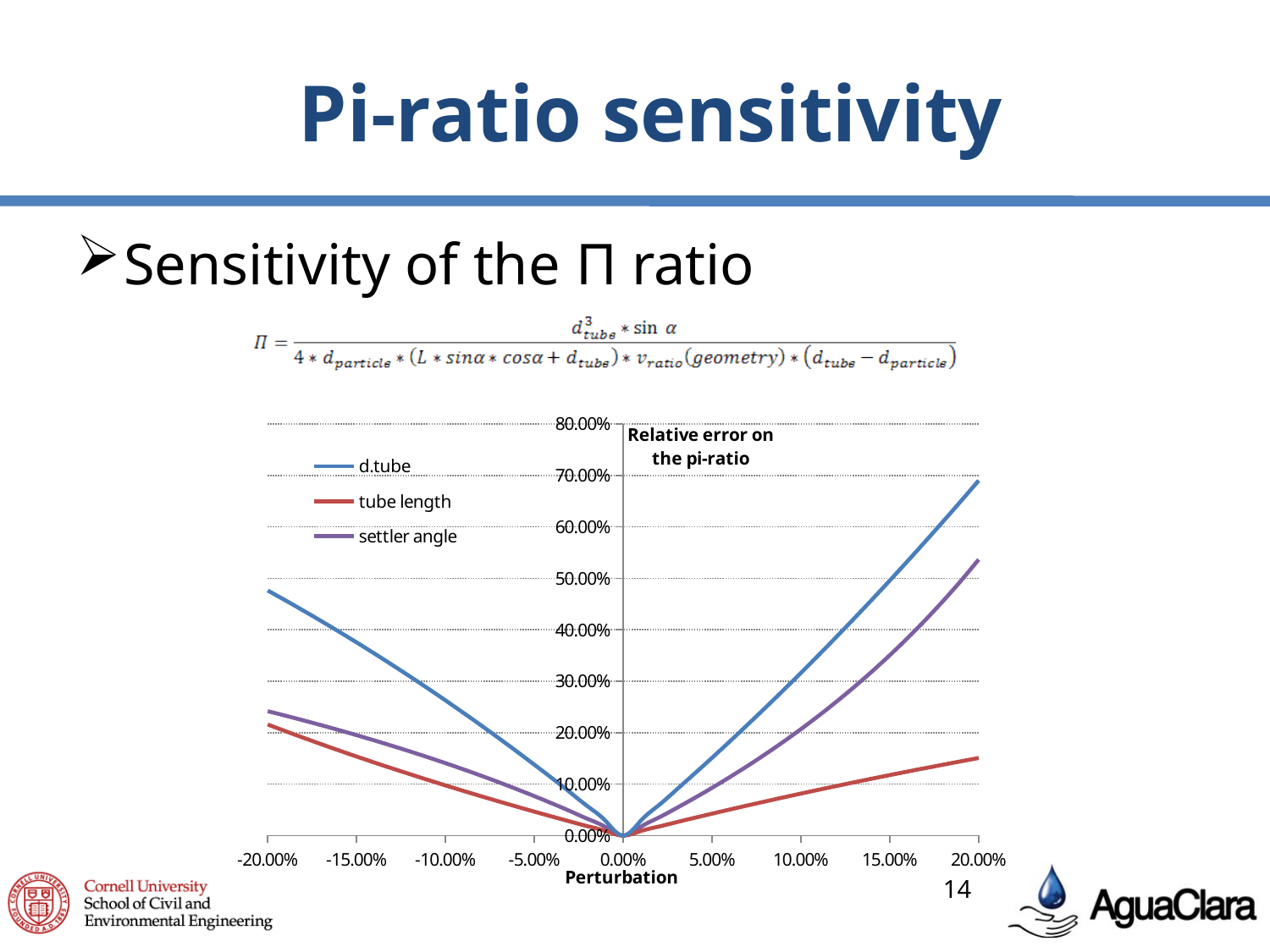
What is the label on the chart's x axis? Perturbation Does the relative error for d.tube rise or fall as the perturbation increases from 0.00% to 20.00%? rise Is the relative error for d.tube at a -20.00% perturbation greater or less than 40.00%? greater How many series does the chart's legend list? 3 Is the relative error for d.tube at a 20.00% perturbation greater or less than 60.00%? greater What kind of chart is shown on the slide? line chart At a 20.00% perturbation, which series has the larger relative error, d.tube or tube length? d.tube Which series has the lowest relative error at a 20.00% perturbation? tube length What are the three series listed in the chart's legend? d.tube, tube length, settler angle Is the relative error for tube length at a 20.00% perturbation greater or less than 20.00%? less Which series has the highest relative error at a 20.00% perturbation? d.tube